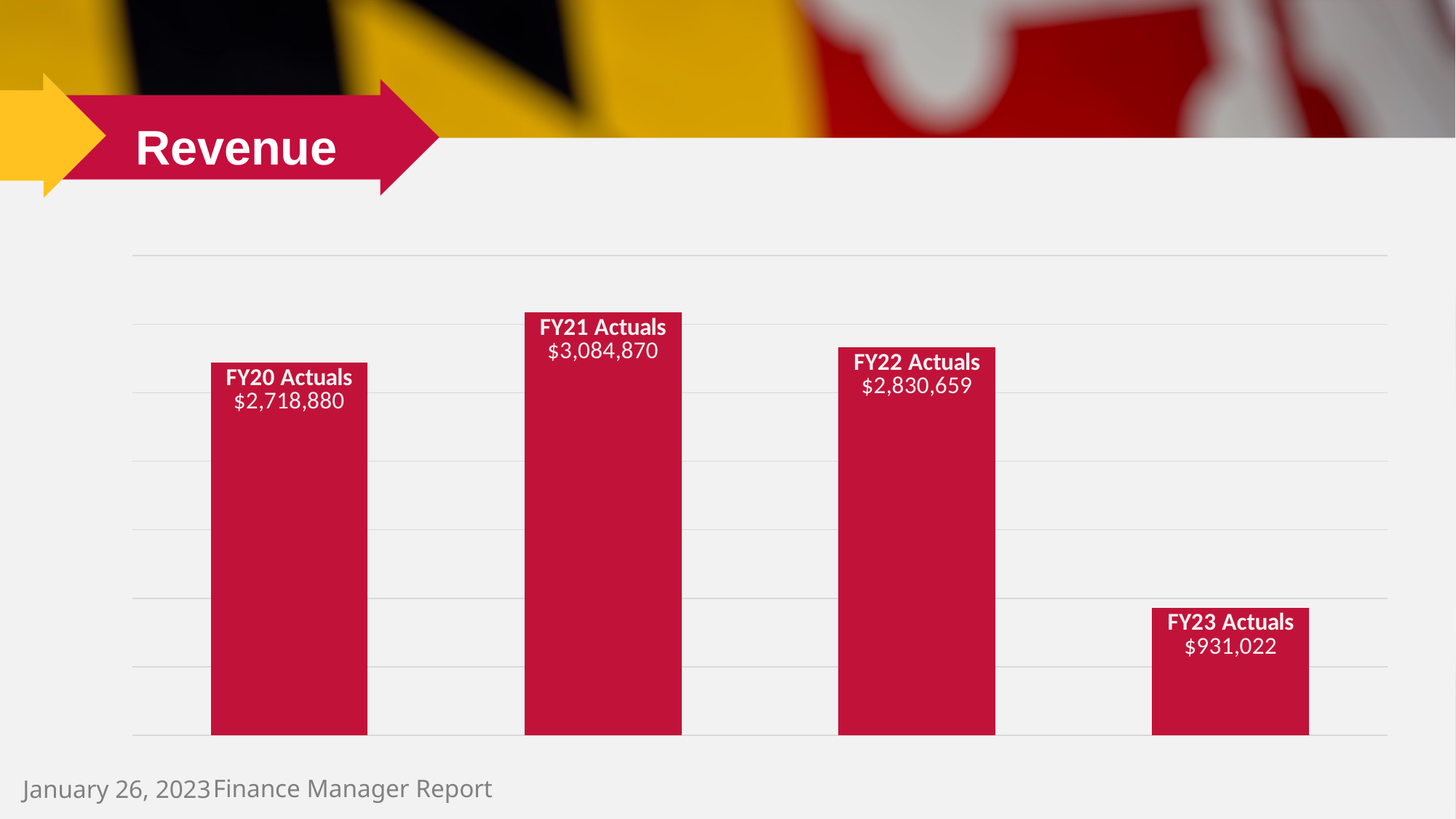
Which fiscal year has the lowest revenue? FY23 Actuals What kind of chart is shown on the slide? Bar chart Which fiscal year has the highest revenue? FY21 Actuals How many bars are shown in the chart? 4 Which is larger, FY20 Actuals or FY22 Actuals? FY22 Actuals What is the difference between FY21 Actuals and FY20 Actuals? $365,990 Does revenue rise or fall from FY22 Actuals to FY23 Actuals? Fall What is the value for FY21 Actuals? $3,084,870 What is the value for FY22 Actuals? $2,830,659 What is the value for FY23 Actuals? $931,022 What is the value for FY20 Actuals? $2,718,880 What is the difference between FY22 Actuals and FY23 Actuals? $1,899,637